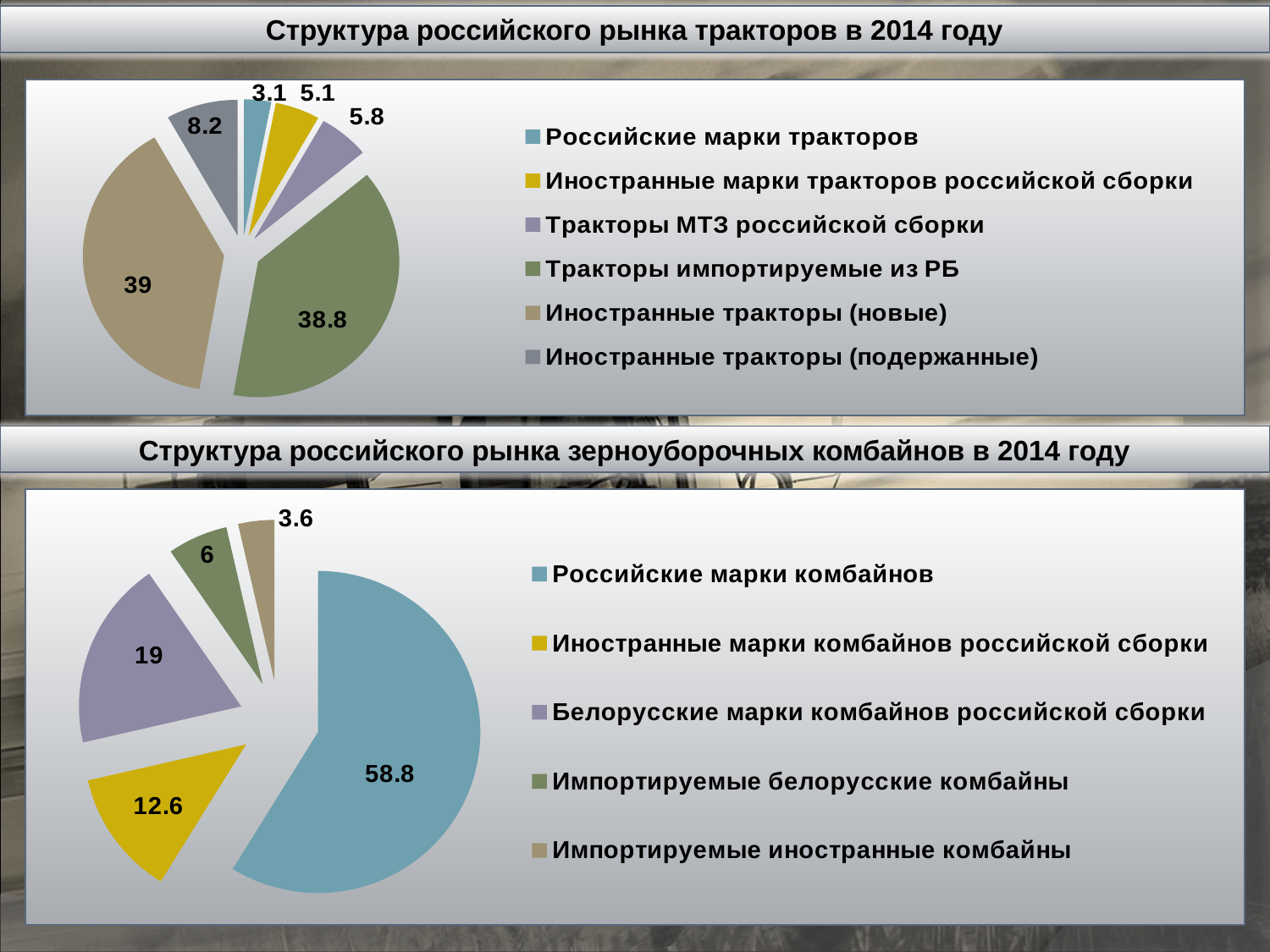
What kind of chart is shown under the title "Структура российского рынка тракторов в 2014 году"? Pie chart In the chart titled "Структура российского рынка зерноуборочных комбайнов в 2014 году", which category has the largest value? Российские марки комбайнов In the chart titled "Структура российского рынка зерноуборочных комбайнов в 2014 году", which is larger: "Иностранные марки комбайнов российской сборки" or "Импортируемые белорусские комбайны"? Иностранные марки комбайнов российской сборки In the chart titled "Структура российского рынка тракторов в 2014 году", what is the difference between "Иностранные тракторы (подержанные)" and "Тракторы МТЗ российской сборки"? 2.4 In the chart titled "Структура российского рынка тракторов в 2014 году", what is the value for "Иностранные тракторы (подержанные)"? 8.2 In the chart titled "Структура российского рынка зерноуборочных комбайнов в 2014 году", what is the value for "Российские марки комбайнов"? 58.8 In the chart titled "Структура российского рынка тракторов в 2014 году", what is the value for "Тракторы импортируемые из РБ"? 38.8 In the chart titled "Структура российского рынка тракторов в 2014 году", which category has the smallest value? Российские марки тракторов In the chart titled "Структура российского рынка зерноуборочных комбайнов в 2014 году", which category has the smallest value? Импортируемые иностранные комбайны In the chart titled "Структура российского рынка зерноуборочных комбайнов в 2014 году", how many slices does the pie have? 5 In the chart titled "Структура российского рынка зерноуборочных комбайнов в 2014 году", what is the value for "Белорусские марки комбайнов российской сборки"? 19 In the chart titled "Структура российского рынка тракторов в 2014 году", how many categories does the legend list? 6